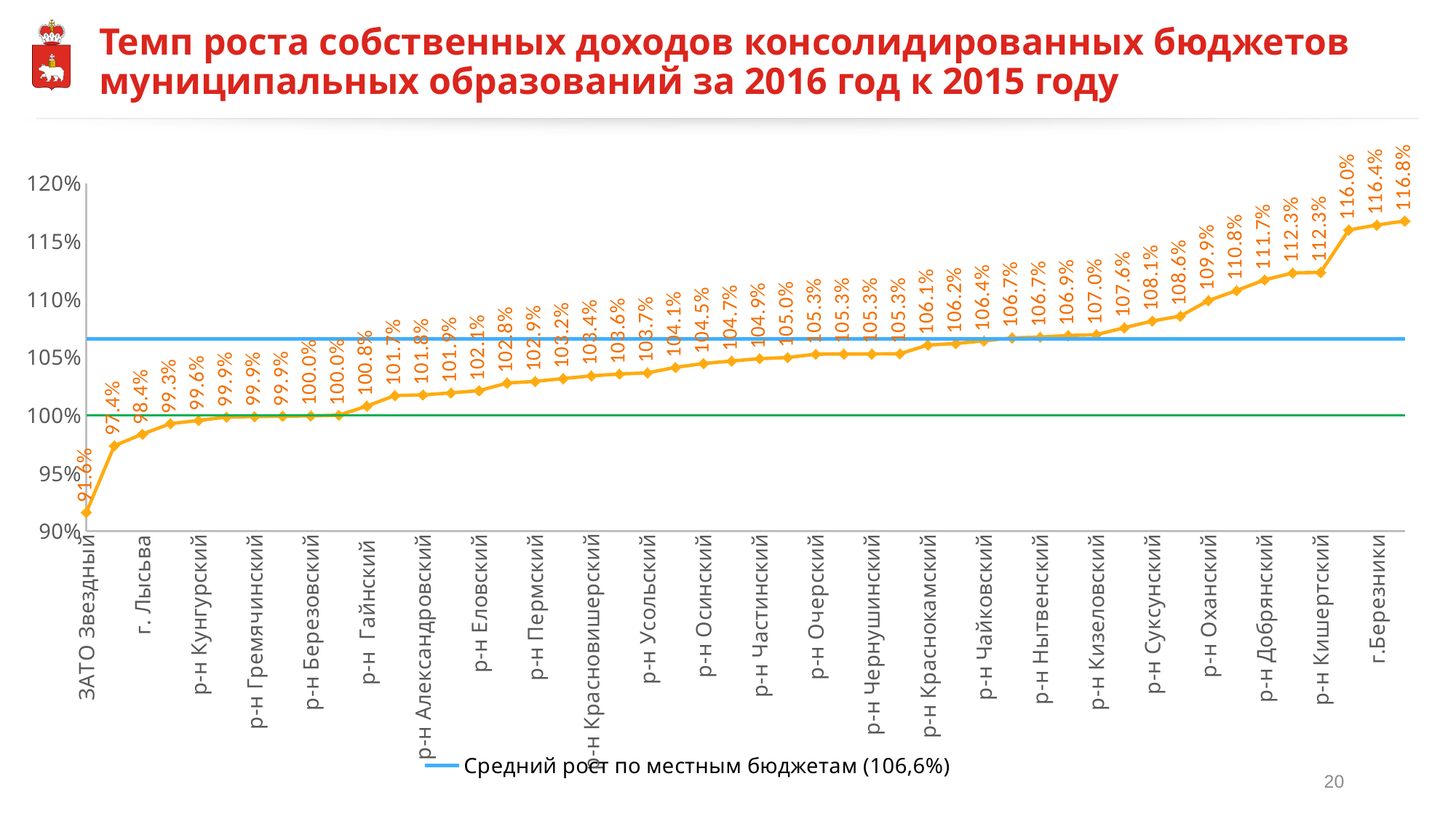
Is the value for г. Лысьва greater or less than 100%? less What is the value for р-н Кишертский? 112.3% What is the value for г.Березники? 116.4% What is the value for р-н Чайковский? 106.4% Do the values rise or fall from left to right along the x axis? rise What is the highest value plotted on the chart? 116.8% What is the difference between the values for г.Березники and ЗАТО Звездный? 24.8 percentage points Which is larger, the value for р-н Оханский or р-н Кунгурский? р-н Оханский What is the value for ЗАТО Звездный? 91.6% What does the blue horizontal line represent according to the legend? Средний рост по местным бюджетам (106,6%) Which category has the lowest value? ЗАТО Звездный What kind of chart is shown on the slide? line chart